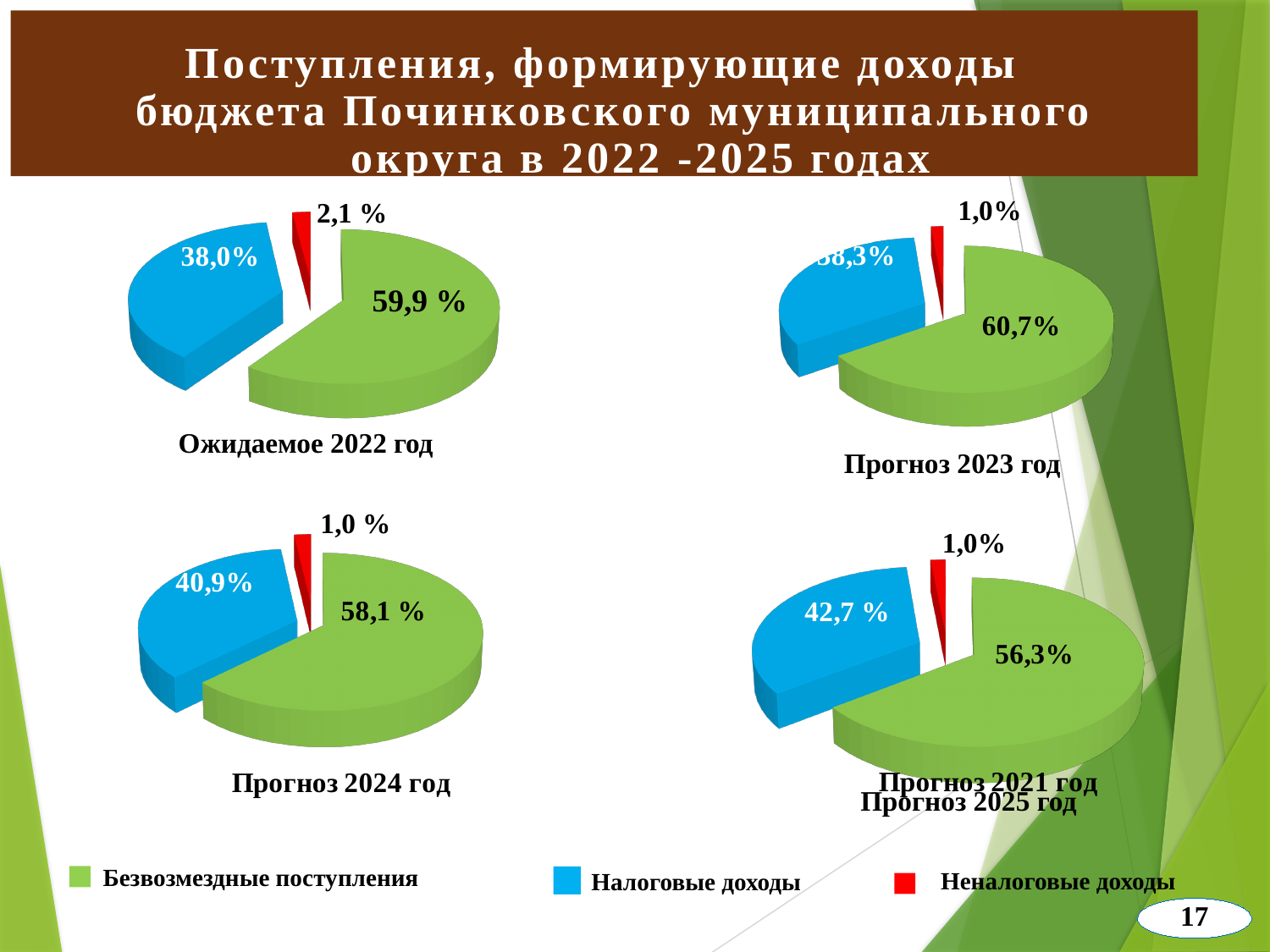
Which colour represents 'Налоговые доходы' in the legend? Blue In the 'Ожидаемое 2022 год' pie chart, what share is labelled on the blue slice (Налоговые доходы)? 38,0% In the 'Ожидаемое 2022 год' pie chart, what share is labelled on the red slice (Неналоговые доходы)? 2,1 % In the 'Ожидаемое 2022 год' pie chart, what share is labelled on the green slice (Безвозмездные поступления)? 59,9 % In the 'Прогноз 2024 год' pie chart, which is larger: the green slice (Безвозмездные поступления) or the blue slice (Налоговые доходы)? Безвозмездные поступления In the 'Прогноз 2023 год' pie chart, what share is labelled on the green slice (Безвозмездные поступления)? 60,7% How many pie charts are on the slide? 4 In the 'Прогноз 2025 год' pie chart (bottom right), which category has the smallest slice? Неналоговые доходы What kind of charts are shown on the slide? Pie charts In the 'Прогноз 2025 год' pie chart (bottom right), what share is labelled on the green slice (Безвозмездные поступления)? 56,3% How many categories does the legend at the bottom of the slide list? 3 In the 'Прогноз 2024 год' pie chart, what share is labelled on the blue slice (Налоговые доходы)? 40,9%